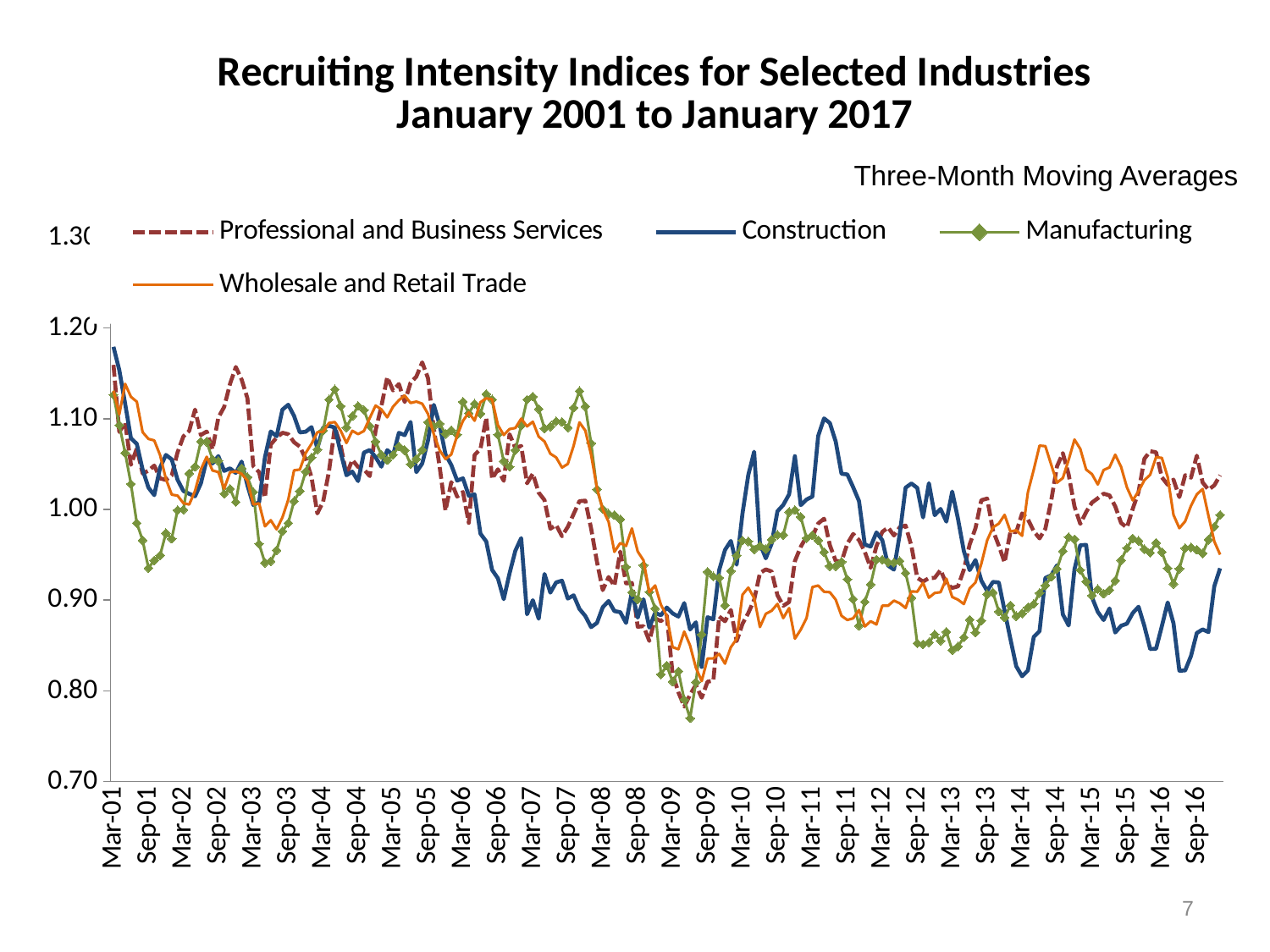
What is the title of the chart? Recruiting Intensity Indices for Selected Industries January 2001 to January 2017 What kind of chart is shown on the slide? Line chart At Mar-14, which series is higher: Wholesale and Retail Trade or Construction? Wholesale and Retail Trade Does the Construction series rise or fall between Mar-06 and Sep-06? Fall How many series does the legend list? 4 Which series is drawn with a dashed line? Professional and Business Services Is the value for Wholesale and Retail Trade at Sep-14 greater or less than 1.00? greater Is the value for Construction at Mar-14 greater or less than 0.90? less Is the value for Construction at Mar-01 greater or less than 1.10? greater Does the Wholesale and Retail Trade series rise or fall overall between Mar-09 and Sep-14? Rise